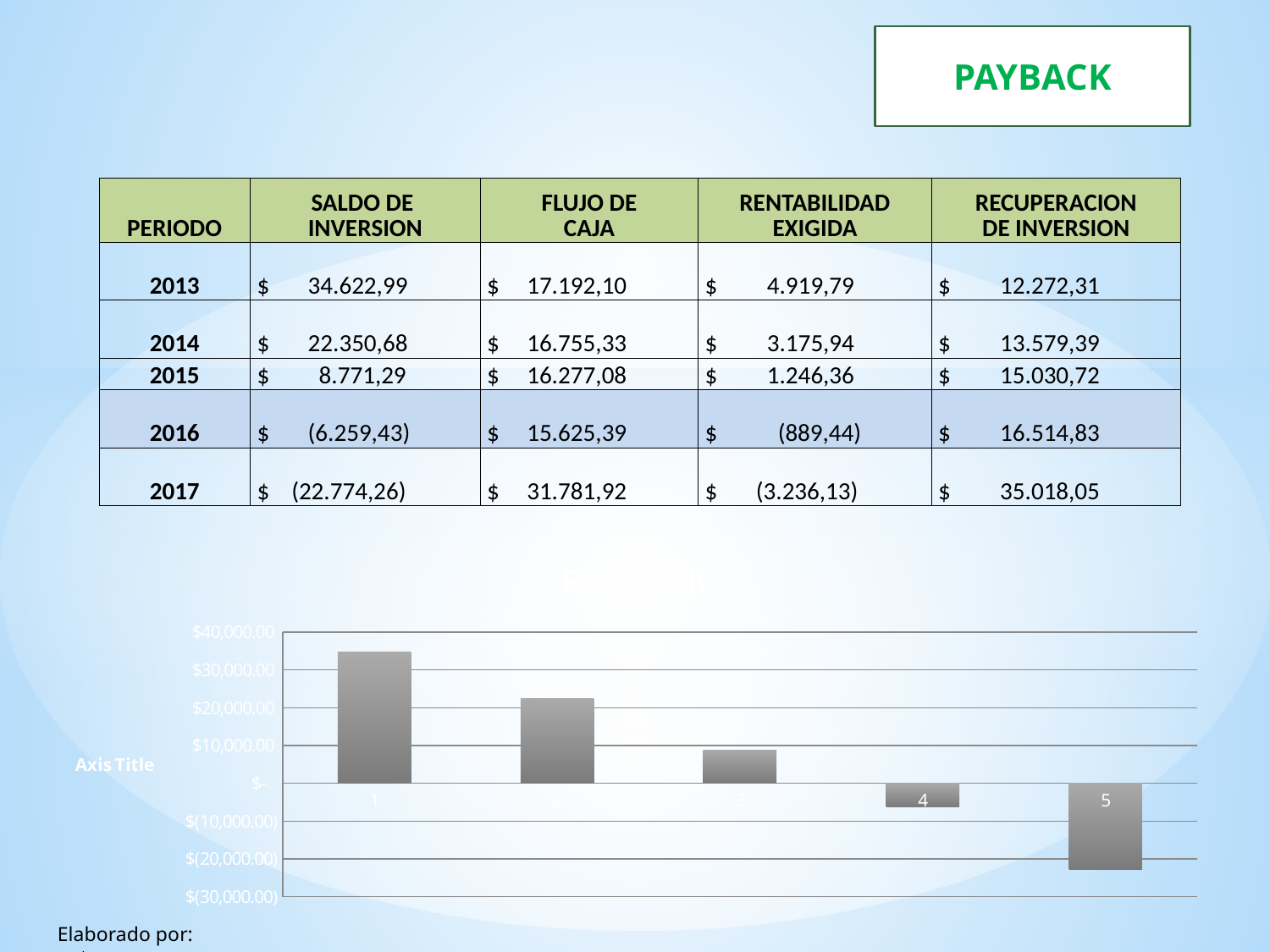
Is the value for category 4 greater or less than $(10,000.00)? greater Which category has the lowest bar in the chart? 5 Which is larger, the value for category 1 or the value for category 2? category 1 What text is shown as the vertical axis title of the chart? Axis Title Is the value for category 5 greater or less than $(20,000.00)? less Is the value for category 3 greater or less than $10,000.00? less Do the bar values rise or fall from category 1 to category 5? fall What kind of chart is shown at the bottom of the slide? bar chart Which category has the highest bar in the chart? 1 How many bars does the chart show? 5 How many bars in the chart extend below $- (zero)? 2